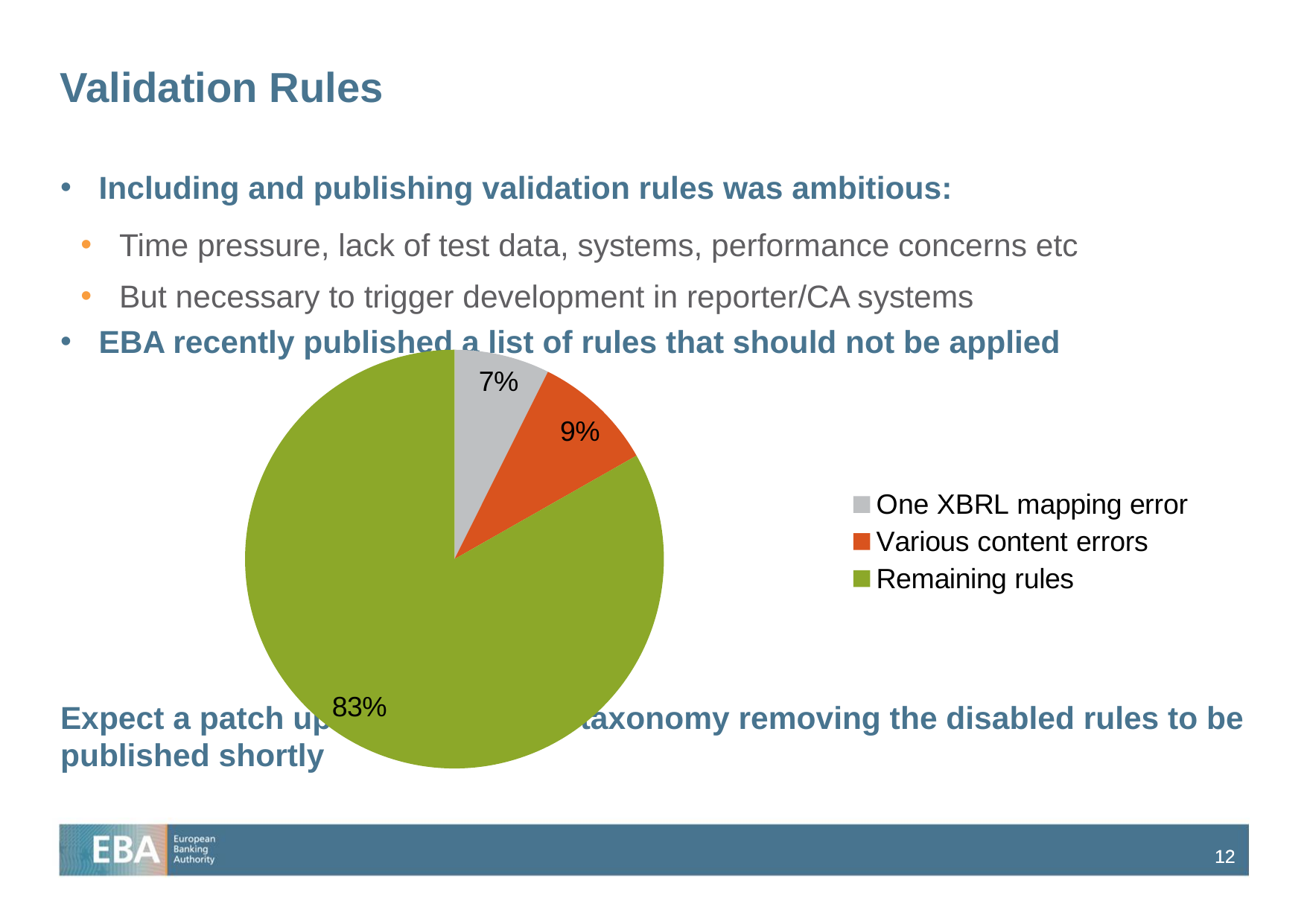
What is the difference in percentage points between "Remaining rules" and "Various content errors"? 74 What share of the pie is labelled "Various content errors"? 9% How many entries does the legend list? 3 How many categories does the pie chart show? 3 Which category has the largest slice of the pie? Remaining rules Which is larger, the slice for "Various content errors" or the slice for "One XBRL mapping error"? Various content errors What share of the pie is labelled "Remaining rules"? 83% What colour is the slice for "Remaining rules"? green Which category has the smallest slice of the pie? One XBRL mapping error What share of the pie is labelled "One XBRL mapping error"? 7% What is the difference in percentage points between "Various content errors" and "One XBRL mapping error"? 2 What kind of chart is shown on the slide? pie chart